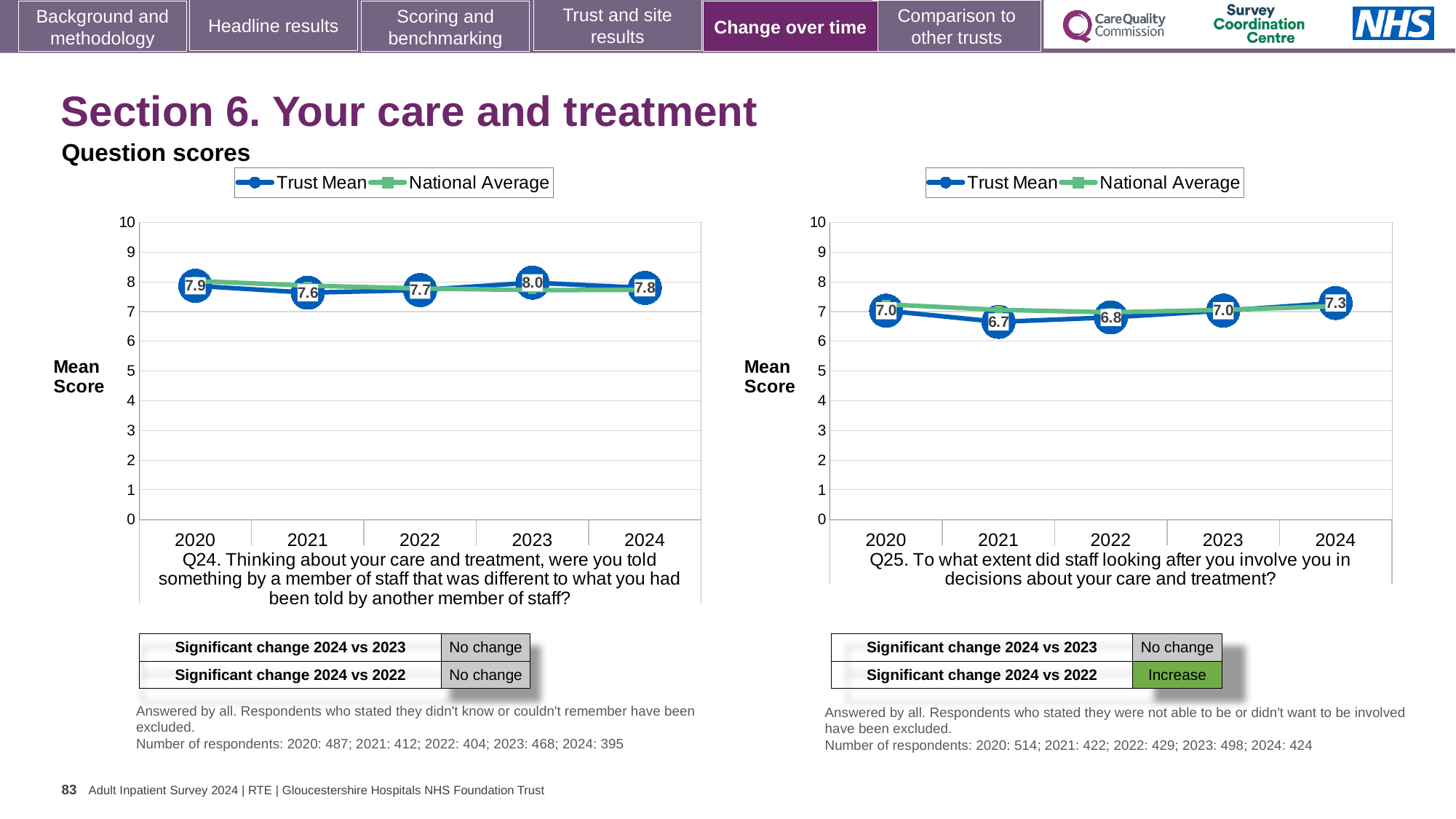
In the Q25 chart on the right, which year has the highest Trust Mean score? 2024 What kind of chart is the Q25 chart on the right? Line chart How many series does the legend of the Q24 chart on the left list? 2 In the Q25 chart on the right, what is the Trust Mean score for 2024? 7.3 In the Q25 chart on the right, what is the Trust Mean score for 2021? 6.7 In the Q24 chart on the left, which year has the lowest Trust Mean score? 2021 In the Q24 chart on the left, which year has the highest Trust Mean score? 2023 In the Q25 chart on the right, how many years are shown on the x axis? 5 In the Q24 chart on the left, what is the Trust Mean score for 2023? 8.0 In the Q24 chart on the left, what is the difference between the Trust Mean scores for 2023 and 2021? 0.4 In the Q25 chart on the right, is the Trust Mean score for 2024 greater or less than 7? greater In the Q24 chart on the left, what is the Trust Mean score for 2021? 7.6